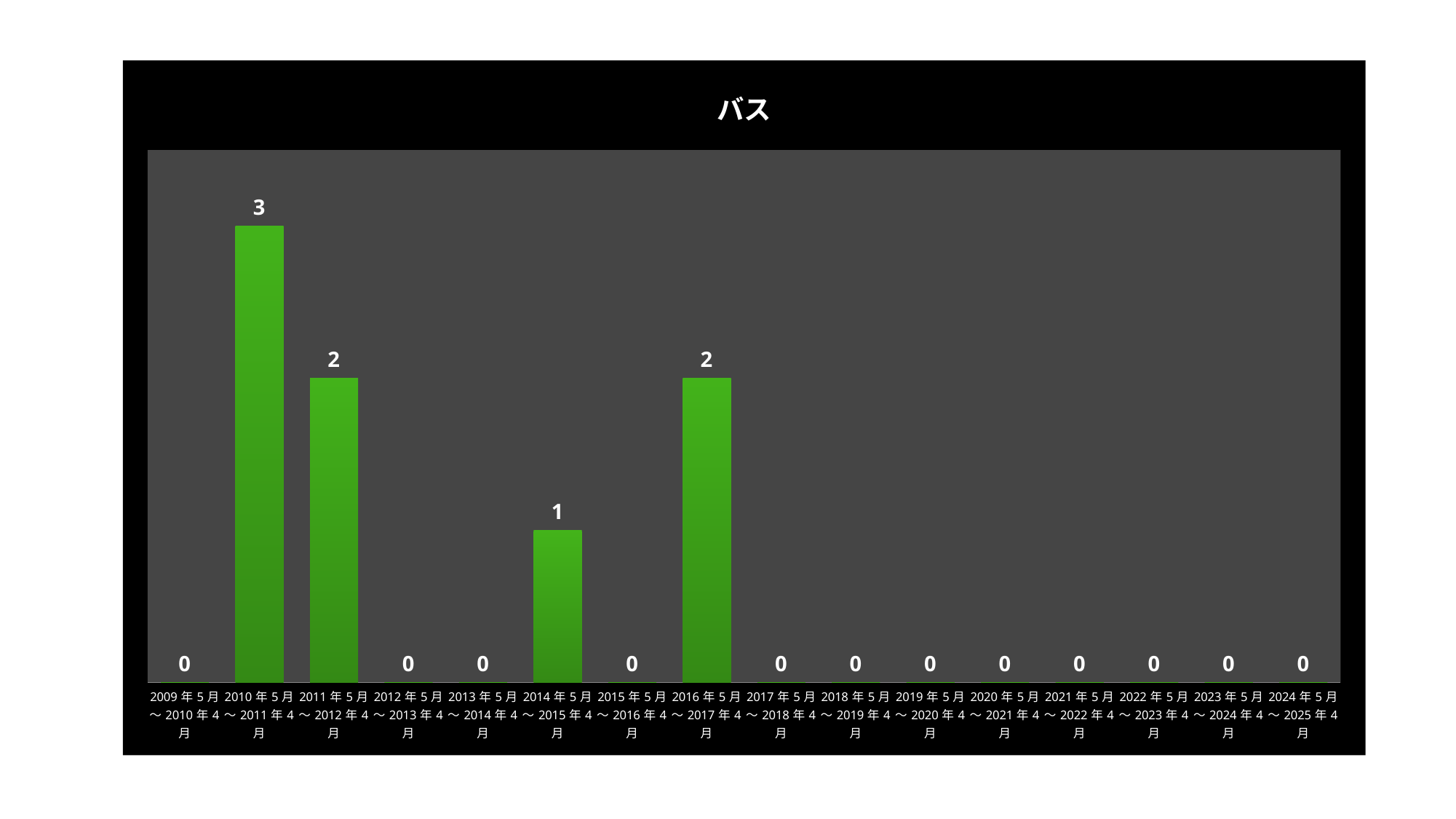
Which period has the highest value? 2010年5月～2011年4月 What is the difference between the values for 2010年5月～2011年4月 and 2014年5月～2015年4月? 2 What is the title of the chart? バス What is the value for the period 2010年5月～2011年4月? 3 Which is larger, the value for 2011年5月～2012年4月 or the value for 2014年5月～2015年4月? 2011年5月～2012年4月 What is the value for the period 2011年5月～2012年4月? 2 What kind of chart is shown on the slide? bar chart How many periods have a value of 0? 12 What is the value for the period 2009年5月～2010年4月? 0 What is the value for the period 2014年5月～2015年4月? 1 What is the value for the period 2016年5月～2017年4月? 2 How many periods (categories) are shown on the x axis? 16